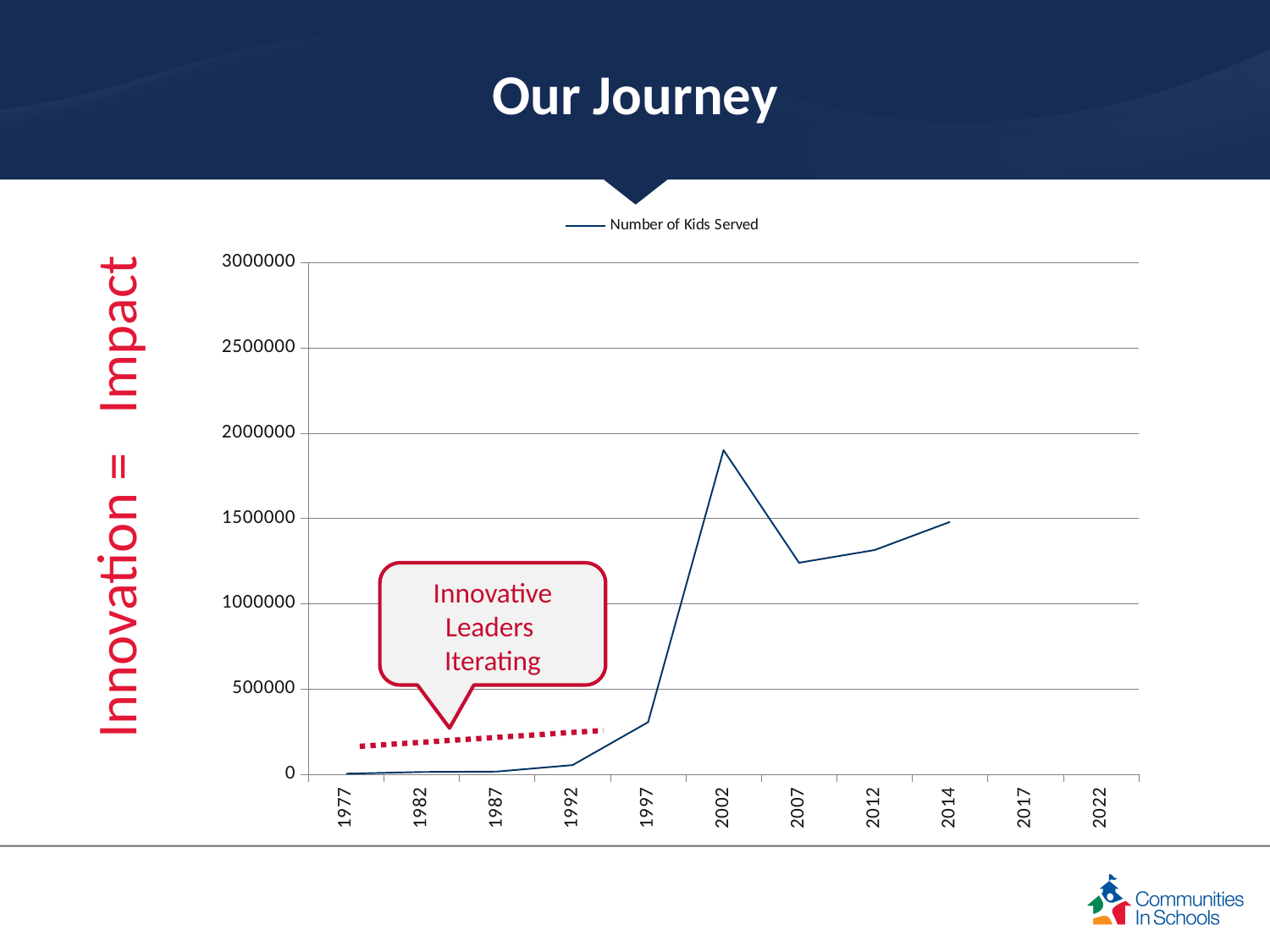
How many year labels are shown on the x axis? 11 Which year has the larger value, 2002 or 2007? 2002 Is the value for 2007 greater or less than 1000000? greater In which year does the Number of Kids Served reach its highest value? 2002 Is the value for 2002 greater or less than 1500000? greater What is the name of the series shown in the legend? Number of Kids Served Does the Number of Kids Served rise or fall between 1992 and 2002? rise Which year has the larger value, 2014 or 2012? 2014 Is the value for 1997 greater or less than 500000? less How many series does the legend list? 1 What kind of chart is shown on the slide? line chart